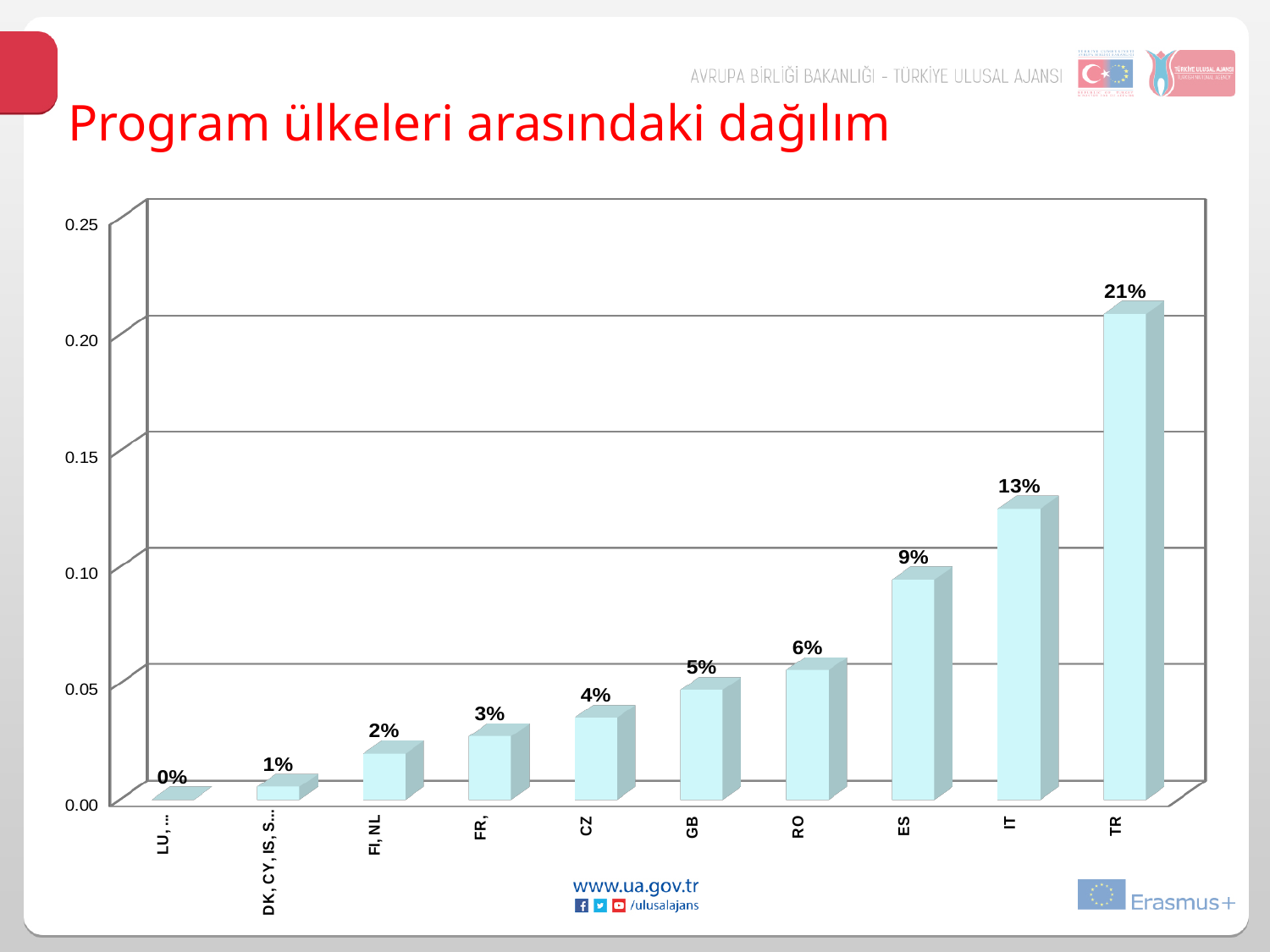
What is the value for ES? 9% What is the difference between the values for TR and IT? 8% Which category has the highest value? TR What is the value for IT? 13% What is the value for GB? 5% How many bars are shown in the chart? 10 What kind of chart is shown on the slide? Bar chart What is the value for RO? 6% What is the value for TR? 21% What is the value for CZ? 4% Which is larger, the value for ES or the value for RO? ES Is the value for TR greater or less than 0.20? greater